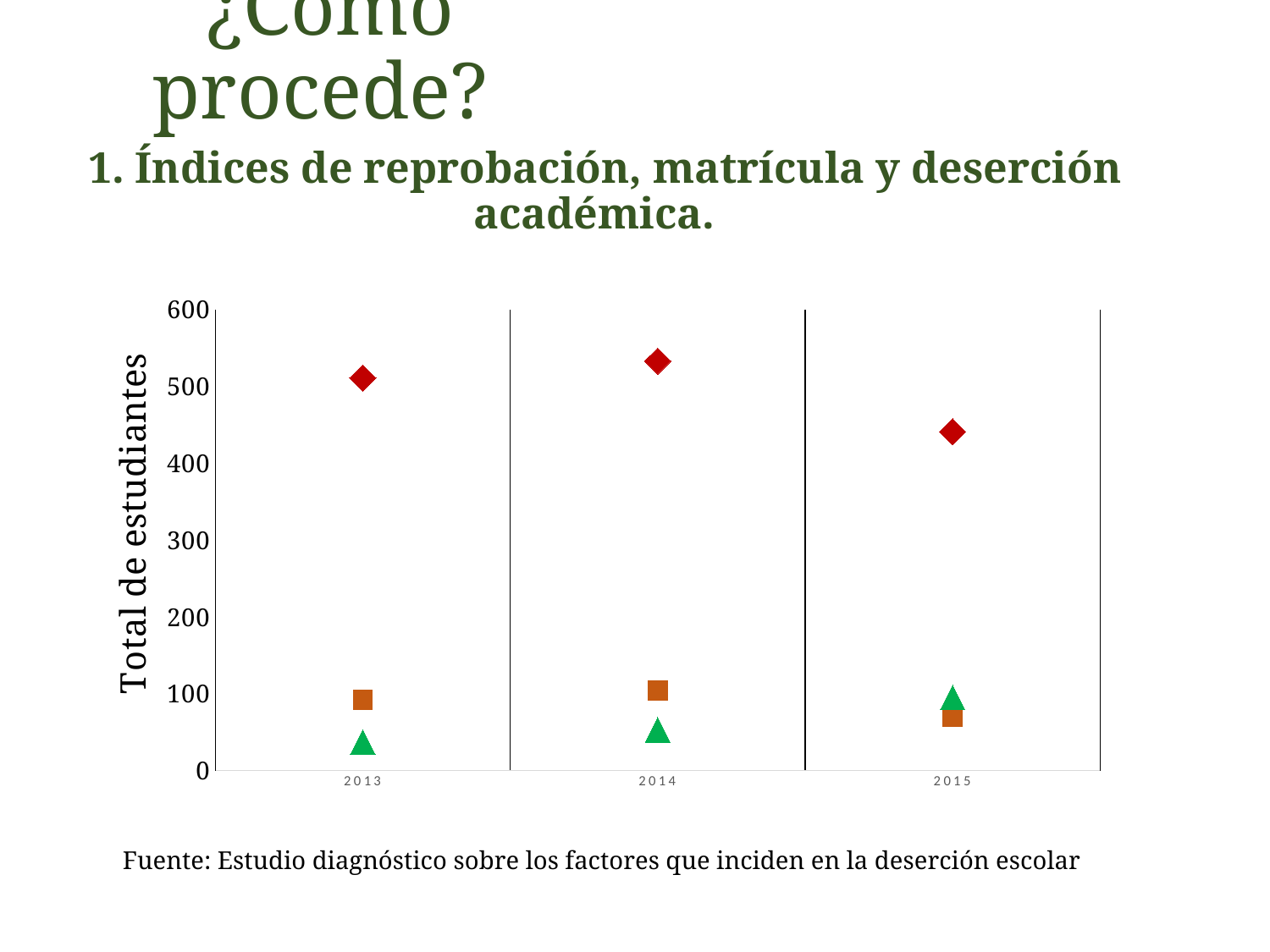
What kind of chart is shown on the slide? Scatter chart Is the value of the red diamond series in 2014 greater or less than 500? greater In which year is the orange square series at its lowest? 2015 In 2015, which is higher: the green triangle series or the orange square series? Green triangle series In which year is the red diamond series at its highest? 2014 In which year is the green triangle series at its lowest? 2013 How many years are shown on the x axis of the chart? 3 Is the value of the red diamond series in 2015 greater or less than 500? less In which year is the red diamond series at its lowest? 2015 What is the title of the vertical axis of the chart? Total de estudiantes Is the value of the green triangle series in 2013 greater or less than 100? less Which years are shown on the x axis of the chart? 2013, 2014, 2015